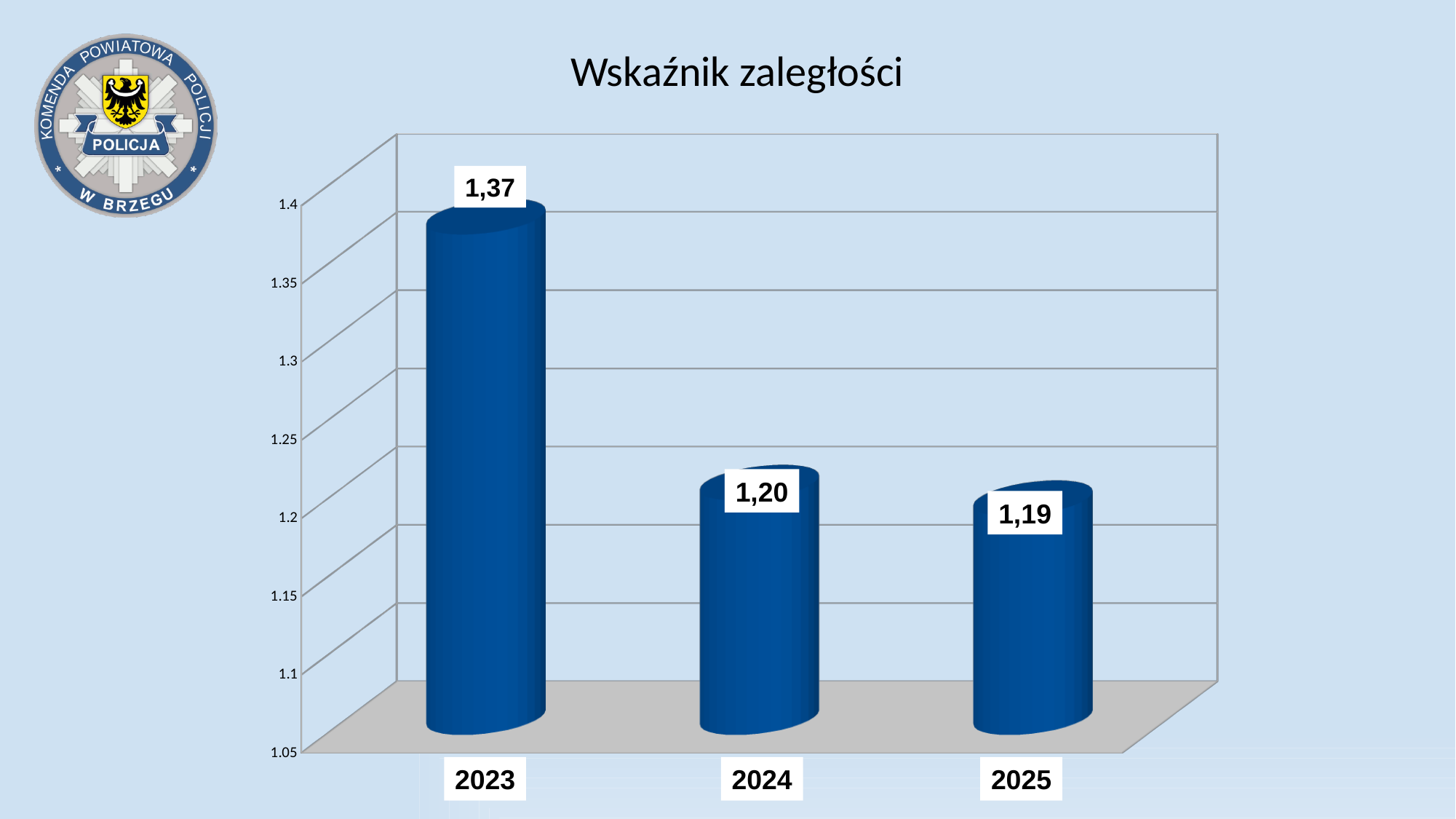
What is the value for 2025? 1,19 Do the values rise or fall from 2023 to 2025? fall What is the difference between the values for 2023 and 2024? 0,17 Is the value for 2023 greater or less than 1.3? greater Which year has the highest value? 2023 What is the value for 2024? 1,20 How many years are shown on the chart? 3 What is the difference between the values for 2024 and 2025? 0,01 Which year has the lowest value? 2025 Which is larger, the value for 2023 or the value for 2025? 2023 What is the value for 2023? 1,37 What kind of chart is this? bar chart